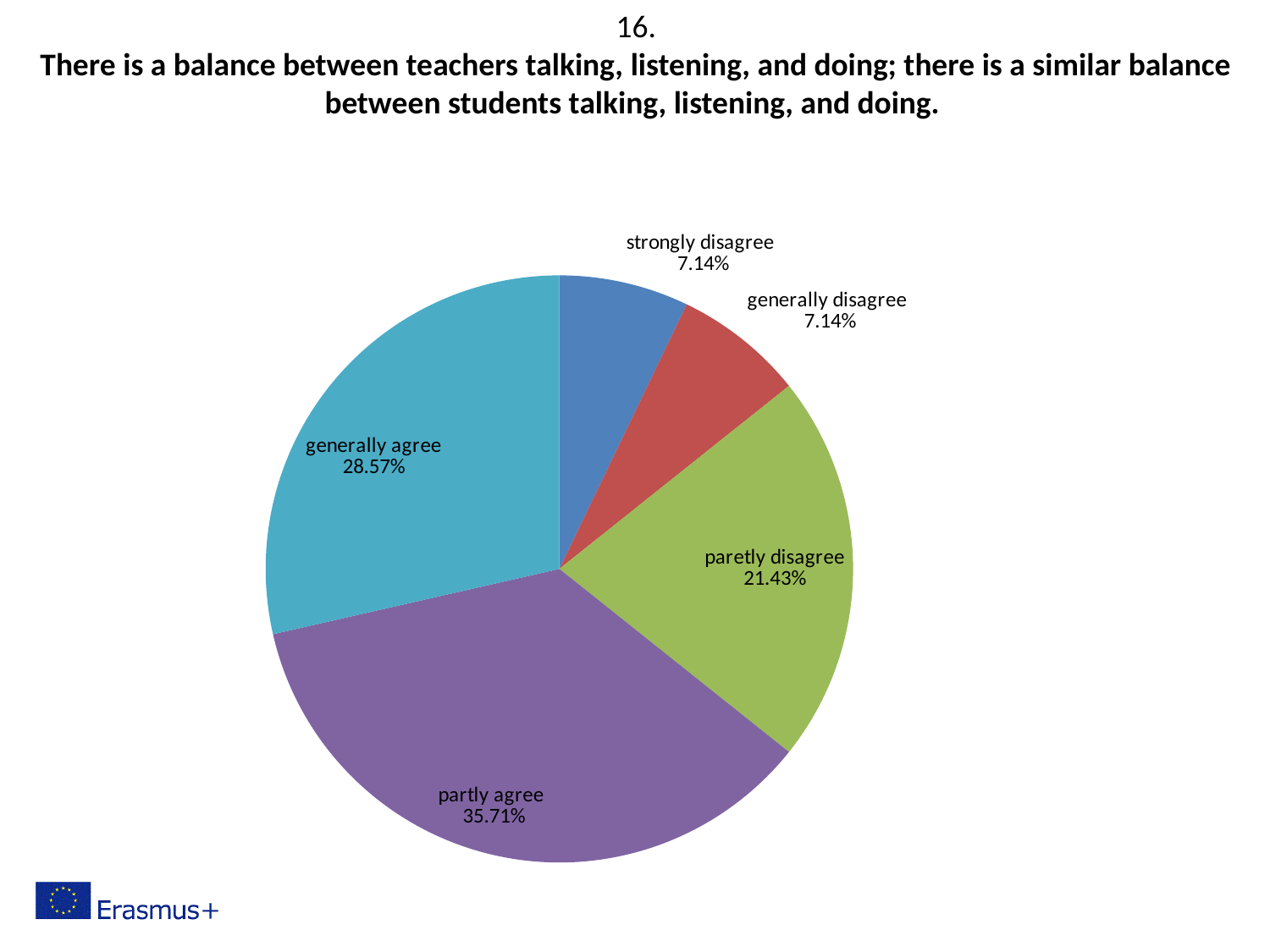
What colour is the "partly agree" slice? purple What kind of chart is shown on the slide? pie chart What share of the pie is labelled "generally agree"? 28.57% Which is larger, the share for "generally agree" or the share for "paretly disagree"? generally agree What number precedes the statement in the chart title? 16. What share of the pie is labelled "partly agree"? 35.71% How many slices does the pie chart have? 5 What share of the pie is labelled "strongly disagree"? 7.14% What is the combined share of "strongly disagree" and "generally disagree"? 14.28% Which category has the largest slice of the pie? partly agree What is the difference between the shares for "partly agree" and "generally agree"? 7.14%